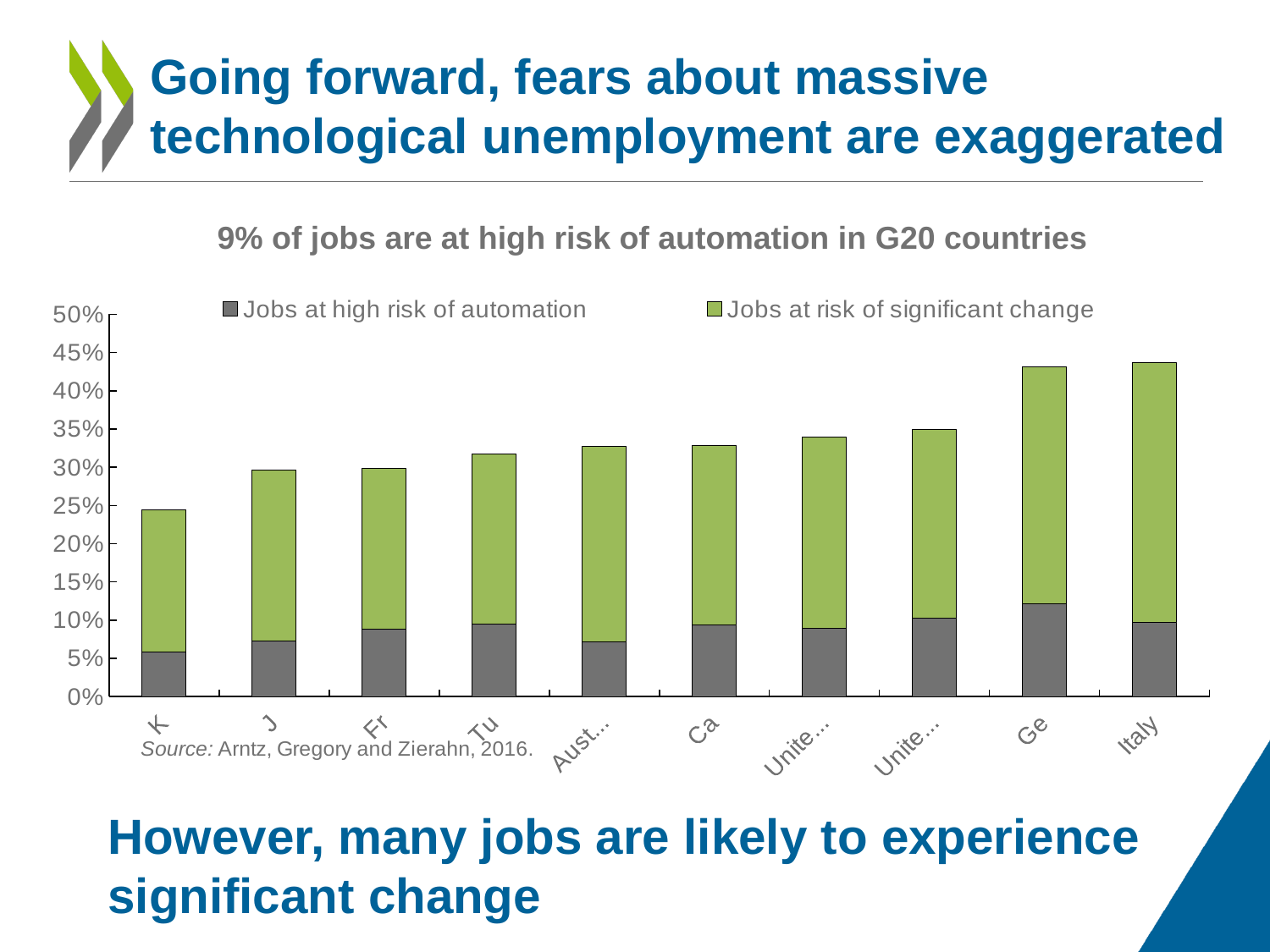
Is the 'Jobs at high risk of automation' value for Italy greater or less than 15%? less How many series does the legend list? 2 Which series is shown in green in the chart? Jobs at risk of significant change Is the total value of the bar for Italy greater or less than 40%? greater What is the title of the chart? 9% of jobs are at high risk of automation in G20 countries Is the total value of the bar for Italy greater or less than 50%? less How many bars (countries) are plotted in the chart? 10 What kind of chart is shown on the slide? Stacked bar chart Do the total bar heights generally rise or fall from left to right along the x axis? rise